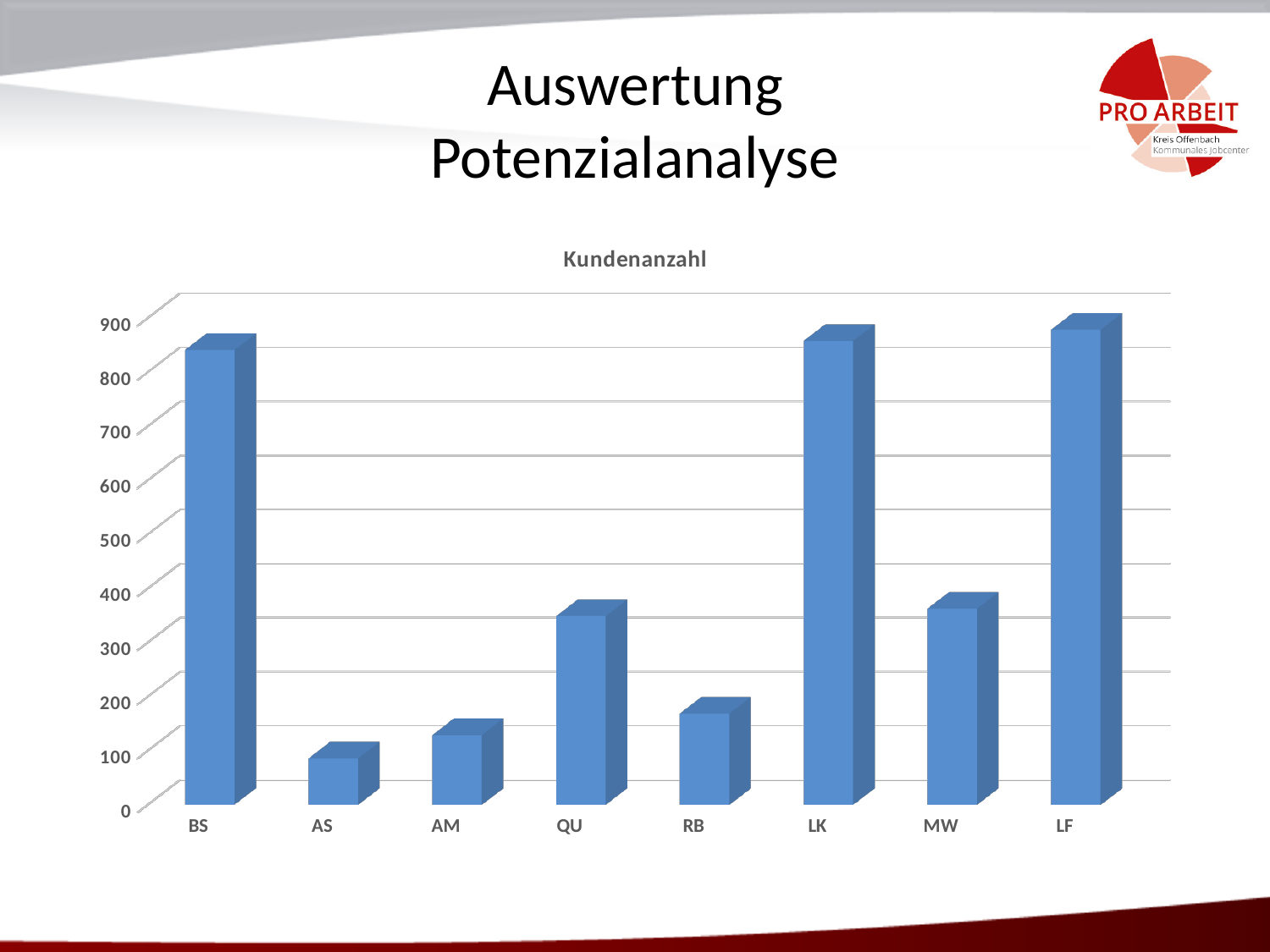
Is the value for RB greater or less than 300? less How many categories are shown on the x axis of the chart? 8 Is the value for MW greater or less than 300? greater Is the value for BS greater or less than 800? greater Which has the larger value, AM or MW? MW What kind of chart is shown on the slide? bar chart Which has the larger value, QU or RB? QU Which category has the lowest value in the chart? AS What is the title of the chart? Kundenanzahl